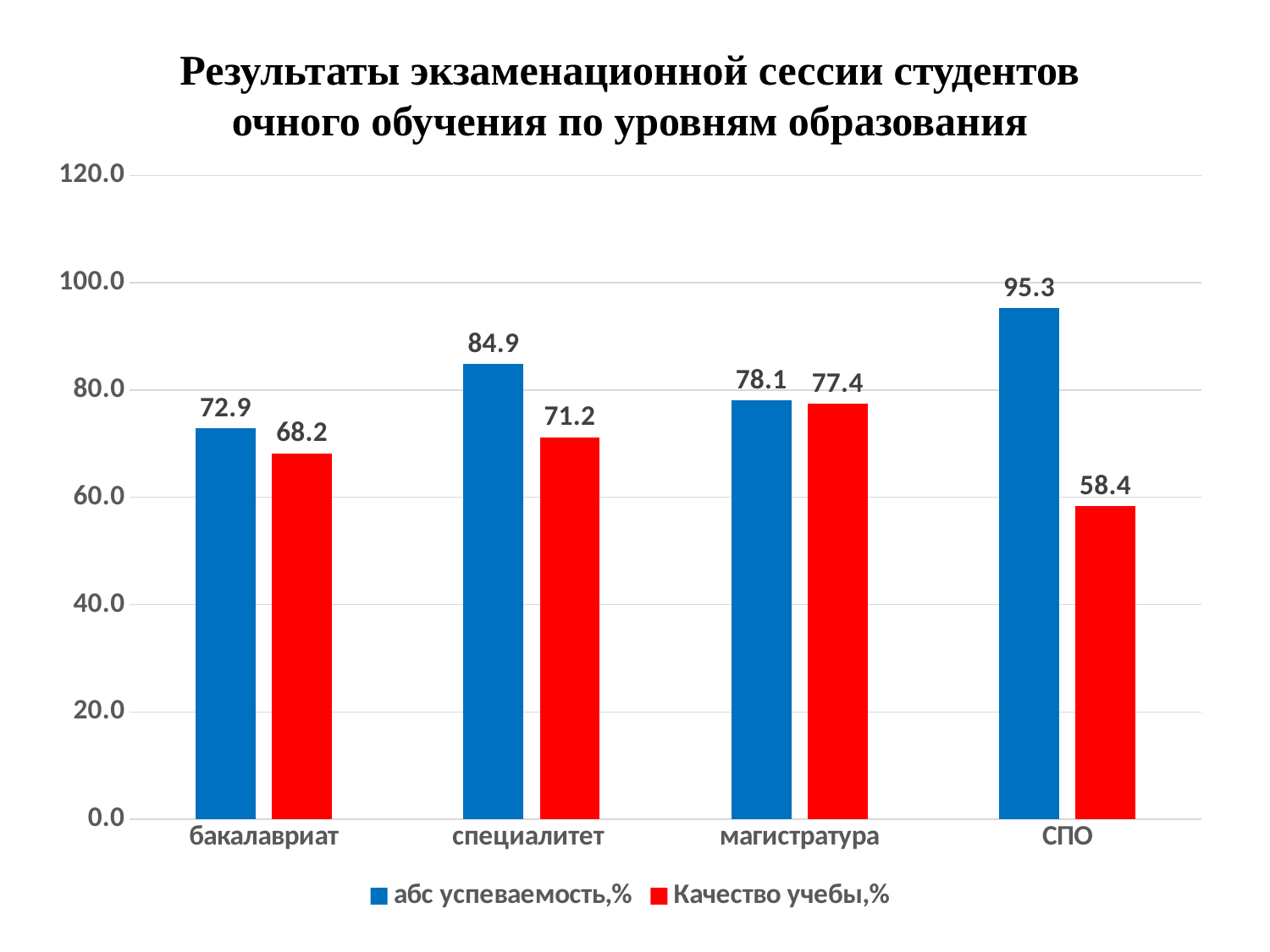
What is the difference between абс успеваемость,% and Качество учебы,% for СПО? 36.9 How many categories are shown on the x axis? 4 What is the value of абс успеваемость,% for бакалавриат? 72.9 Which category has the highest абс успеваемость,%? СПО Which is larger: Качество учебы,% for специалитет or for бакалавриат? специалитет Which category has the lowest Качество учебы,%? СПО Is the value of абс успеваемость,% for специалитет greater or less than 80.0? greater How many series does the legend list? 2 What kind of chart is shown on the slide? bar chart What is the value of Качество учебы,% for СПО? 58.4 What is the difference between абс успеваемость,% for специалитет and for бакалавриат? 12.0 What is the value of Качество учебы,% for магистратура? 77.4